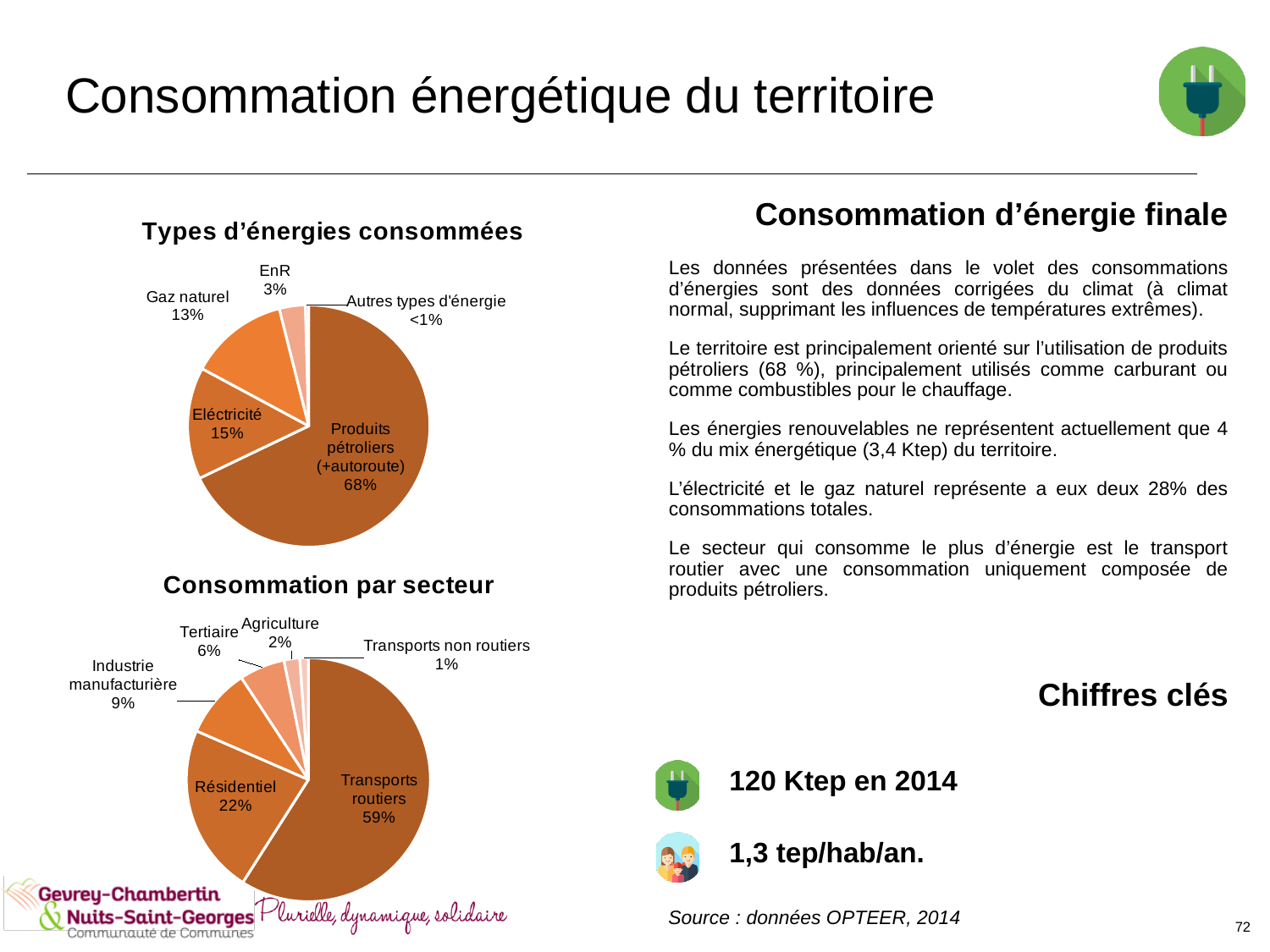
In the 'Types d'énergies consommées' chart, how many categories are shown? 5 In the 'Consommation par secteur' chart, what share is shown for Transports routiers? 59% In the 'Types d'énergies consommées' chart, what is the difference between the shares of Eléctricité and EnR? 12% What kind of chart is 'Consommation par secteur'? Pie chart In the 'Consommation par secteur' chart, how many categories are shown? 6 In the 'Consommation par secteur' chart, what is the difference between the shares of Tertiaire and Agriculture? 4% In the 'Consommation par secteur' chart, which is larger: Résidentiel or Tertiaire? Résidentiel In the 'Types d'énergies consommées' chart, what share is shown for Produits pétroliers (+autoroute)? 68% In the 'Consommation par secteur' chart, which category has the largest share? Transports routiers In the 'Types d'énergies consommées' chart, which category has the smallest share? Autres types d'énergie In the 'Types d'énergies consommées' chart, what share is shown for Gaz naturel? 13%